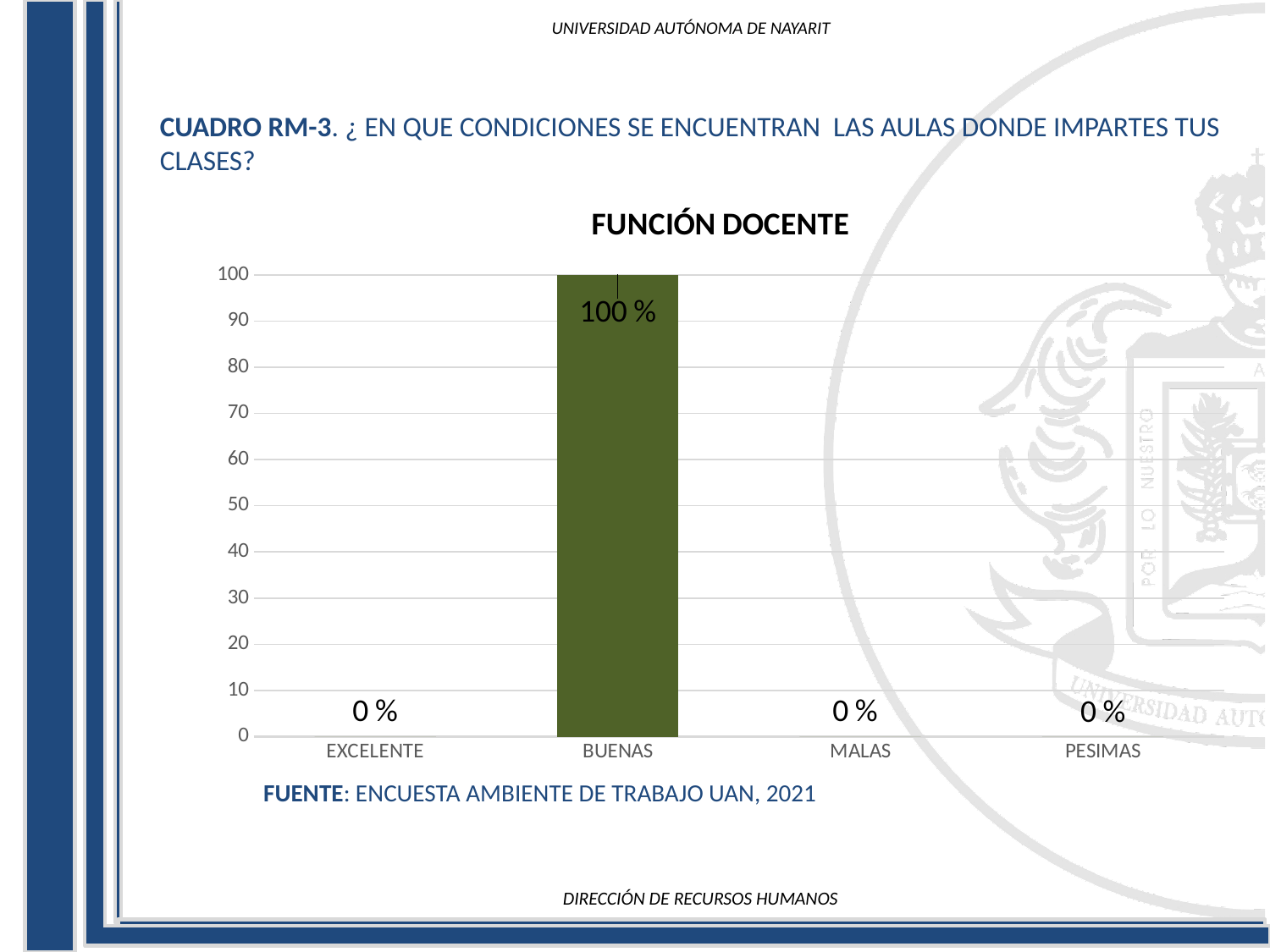
What is the value for BUENAS? 100 % What is the highest value shown on the y axis? 100 Is the value for BUENAS greater or less than 50? greater Which is larger, the value for BUENAS or the value for EXCELENTE? BUENAS How many categories are shown on the x axis? 4 What is the value for MALAS? 0 % What is the difference between the values for BUENAS and MALAS? 100 % What is the title of the chart? FUNCIÓN DOCENTE What is the value for EXCELENTE? 0 % Which category has the highest value? BUENAS What is the value for PESIMAS? 0 % What kind of chart is shown? bar chart